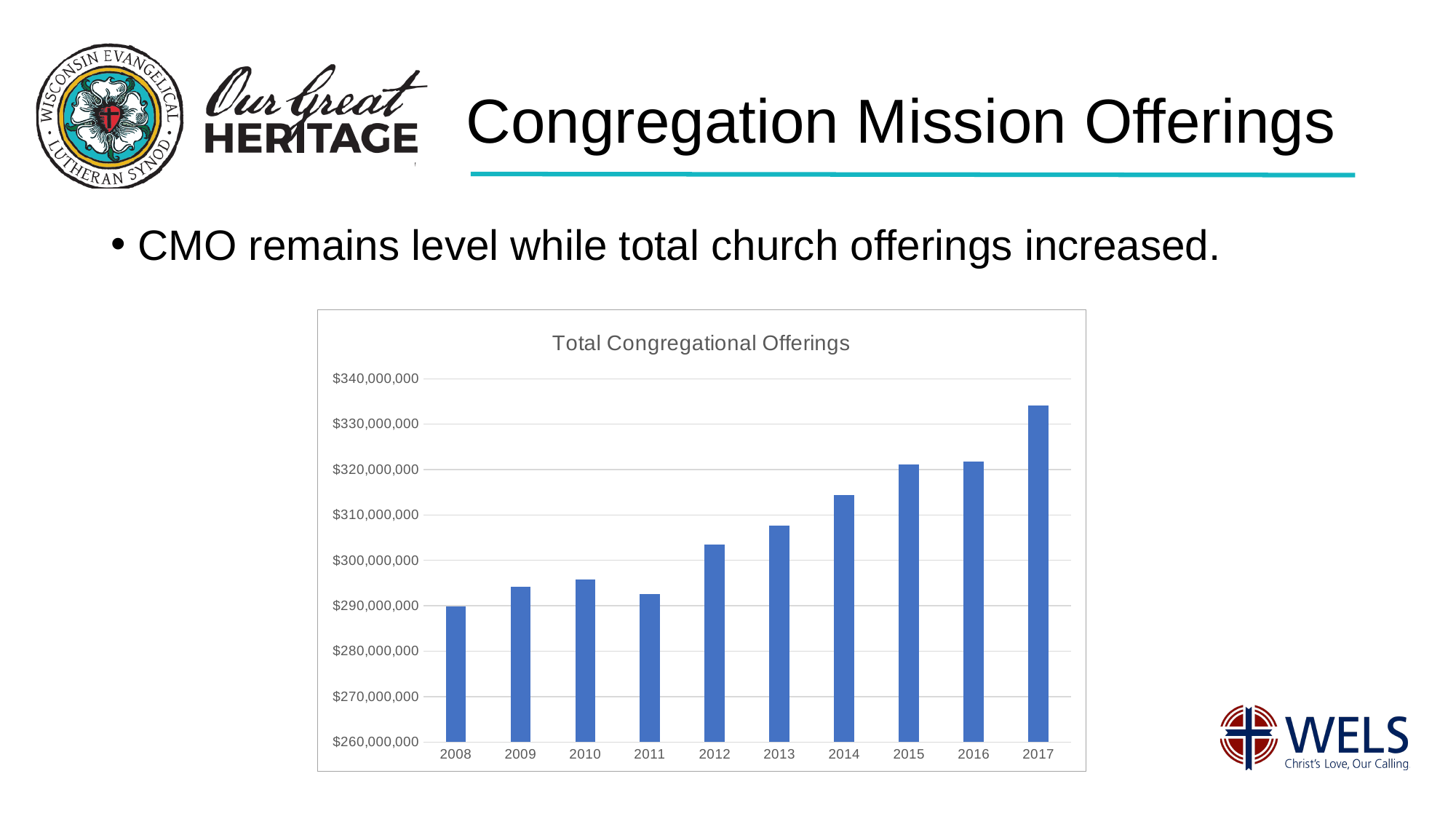
Which year has the highest total congregational offerings? 2017 How many years are shown on the x axis of the chart? 10 Overall, do total congregational offerings rise or fall from 2008 to 2017? rise Which year has the larger total congregational offerings, 2014 or 2010? 2014 Which year has the lowest total congregational offerings? 2008 Is the value for 2011 greater or less than $300,000,000? less Is the value for 2014 greater or less than $310,000,000? greater Is the value for 2013 greater or less than $310,000,000? less What type of chart is shown on the slide? bar chart Which year has the larger total congregational offerings, 2011 or 2012? 2012 What is the title of the chart? Total Congregational Offerings